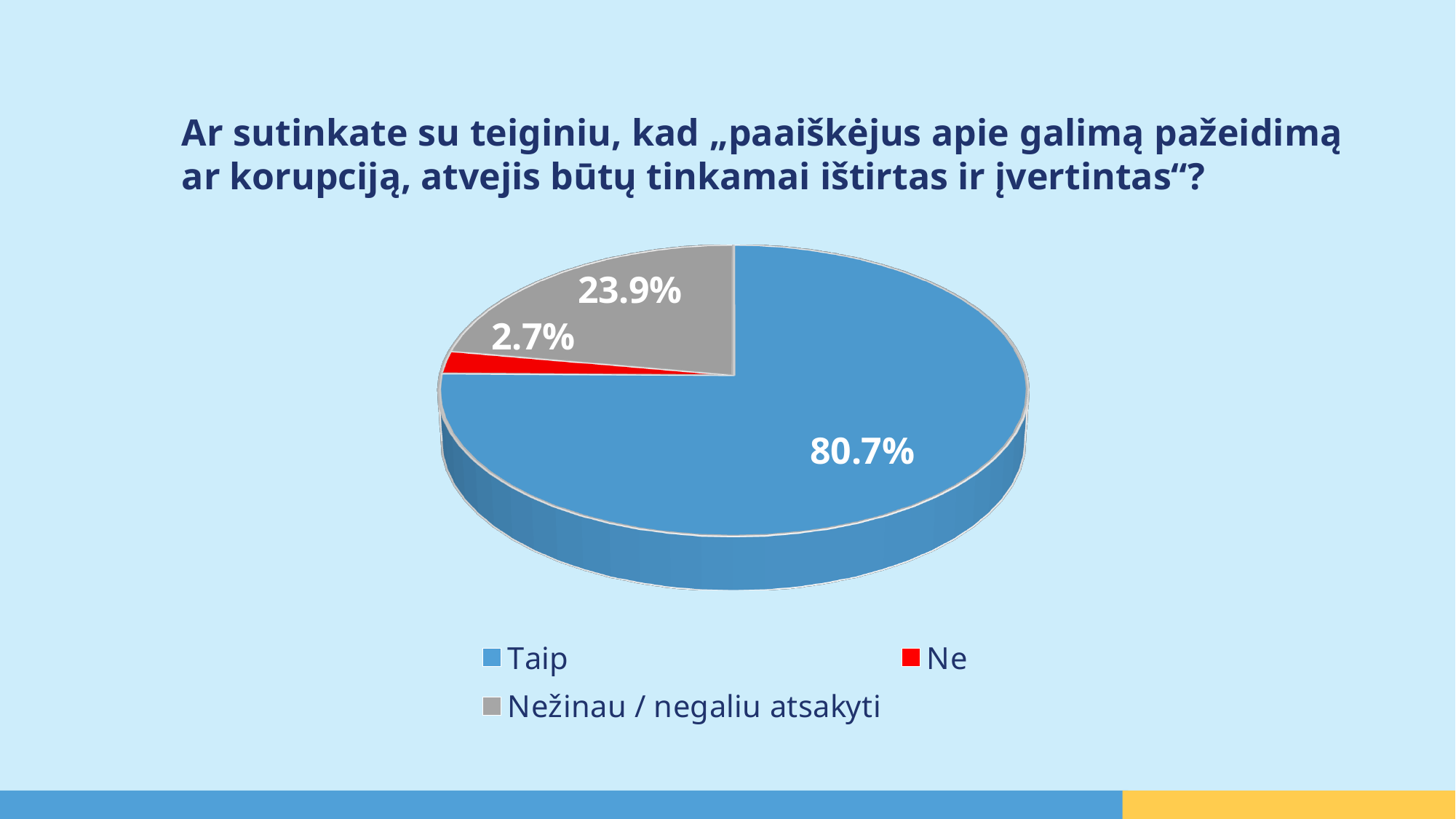
What percentage of respondents answered "Nežinau / negaliu atsakyti"? 23.9% What is the difference in percentage points between "Taip" and "Nežinau / negaliu atsakyti"? 56.8 What type of chart is shown on the slide? pie chart Which answer has the smallest share of the pie? Ne How many slices does the pie chart have? 3 What percentage of respondents answered "Taip"? 80.7% Which answer has the largest share of the pie? Taip What percentage of respondents answered "Ne"? 2.7% Which is larger, the share for "Ne" or the share for "Nežinau / negaliu atsakyti"? Nežinau / negaliu atsakyti What colour is the slice for "Ne"? red What is the difference in percentage points between "Nežinau / negaliu atsakyti" and "Ne"? 21.2 How many entries does the legend list? 3